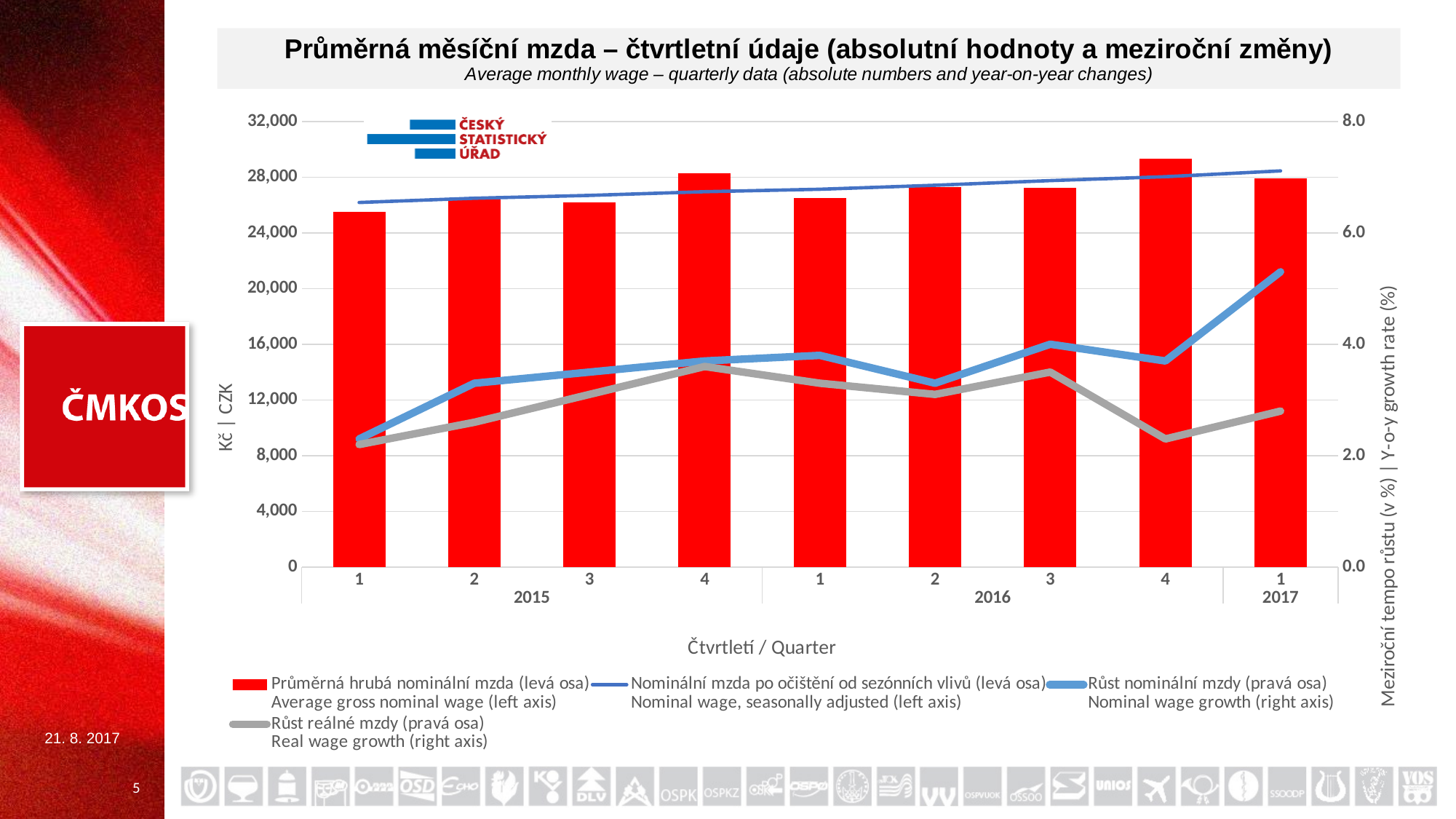
In Q1 2017, which is larger: nominal wage growth or real wage growth? Nominal wage growth Is the real wage growth for Q4 2015 greater or less than 4.0? less In which quarter is the average gross nominal wage bar the lowest? Q1 2015 Which series is plotted on the right axis in grey? Real wage growth (Růst reálné mzdy) Does the seasonally adjusted nominal wage line rise or fall from Q1 2015 to Q1 2017? rise In which quarter is the average gross nominal wage bar the highest? Q4 2016 Is the average gross nominal wage for Q4 2016 greater or less than 28,000? greater Is the nominal wage growth for Q1 2017 greater or less than 4.0? greater How many series does the legend list? 4 What kind of chart is shown on the slide? Combined bar and line chart How many quarters are plotted along the x axis? 9